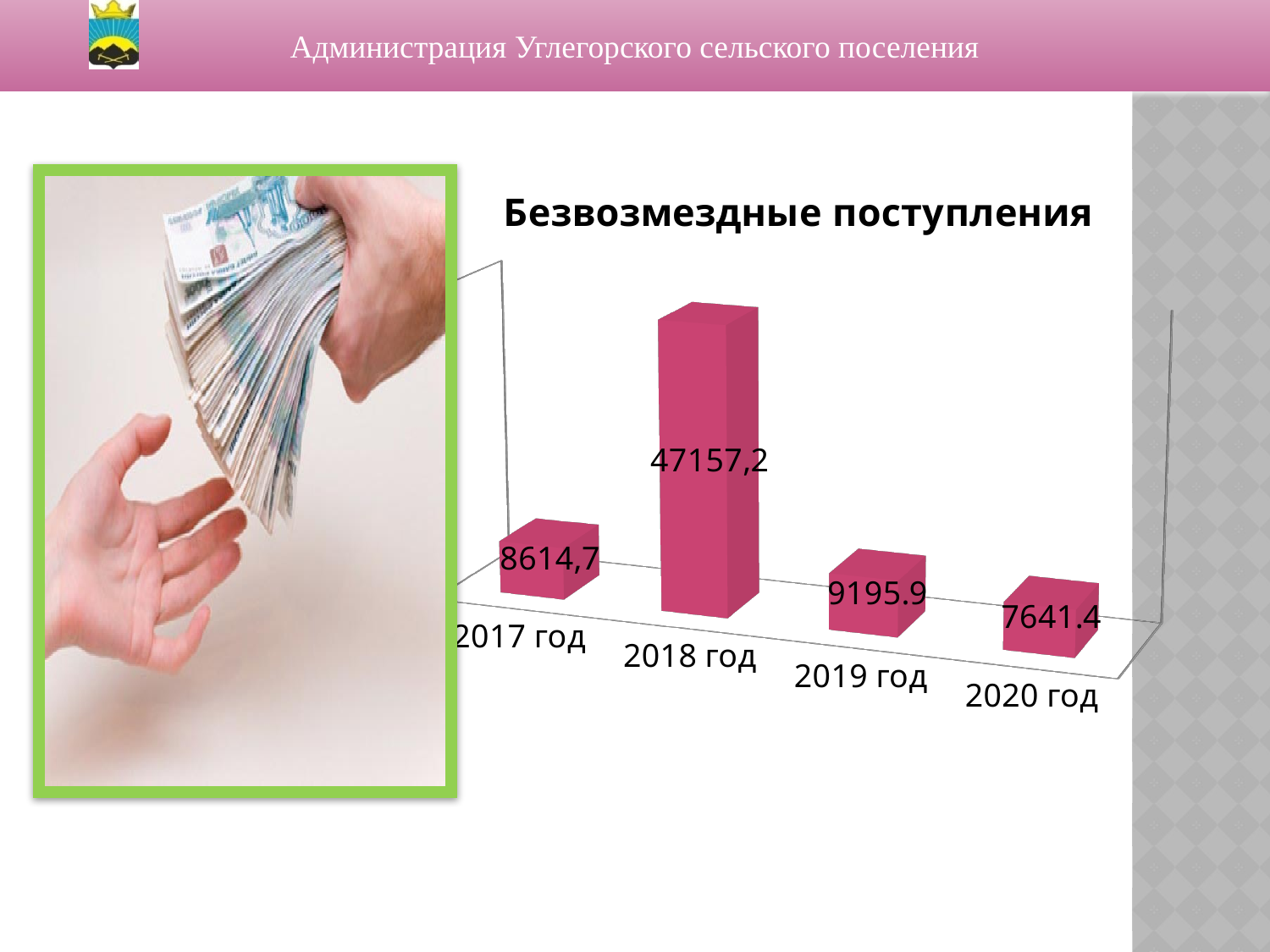
What is the value for 2018 год in the Безвозмездные поступления chart? 47157,2 Which year has the lowest value in the Безвозмездные поступления chart? 2020 год Which is larger in the Безвозмездные поступления chart, the value for 2019 год or 2020 год? 2019 год What kind of chart is the Безвозмездные поступления chart? bar chart What is the value for 2017 год in the Безвозмездные поступления chart? 8614,7 What is the difference between the values for 2019 год and 2020 год in the Безвозмездные поступления chart? 1554.5 Do the values in the Безвозмездные поступления chart rise or fall from 2018 год to 2020 год? fall Which year has the highest value in the Безвозмездные поступления chart? 2018 год What is the value for 2019 год in the Безвозмездные поступления chart? 9195.9 What is the value for 2020 год in the Безвозмездные поступления chart? 7641.4 What is the difference between the values for 2018 год and 2017 год in the Безвозмездные поступления chart? 38542,5 How many years are shown in the Безвозмездные поступления chart? 4